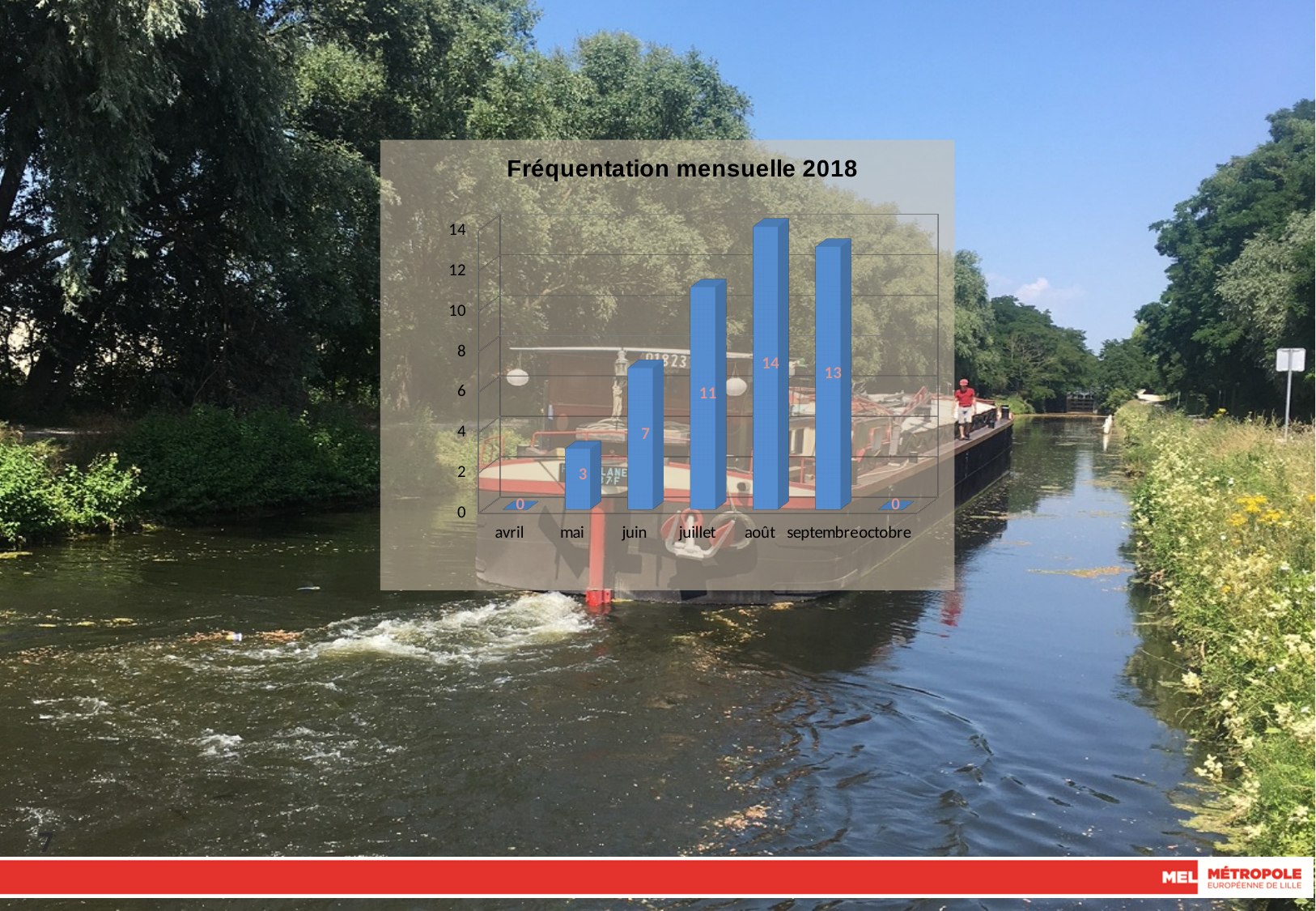
What is the value for mai? 3 How many months are shown on the x axis? 7 What kind of chart is shown? bar chart What is the title of the chart? Fréquentation mensuelle 2018 What is the value for août? 14 Do the values rise or fall from avril to août? rise Which is larger, the value for juillet or the value for septembre? septembre Which month has the highest value? août What is the value for juillet? 11 What is the difference between the values for août and juin? 7 Is the value for juin greater or less than 6? greater What is the value for septembre? 13